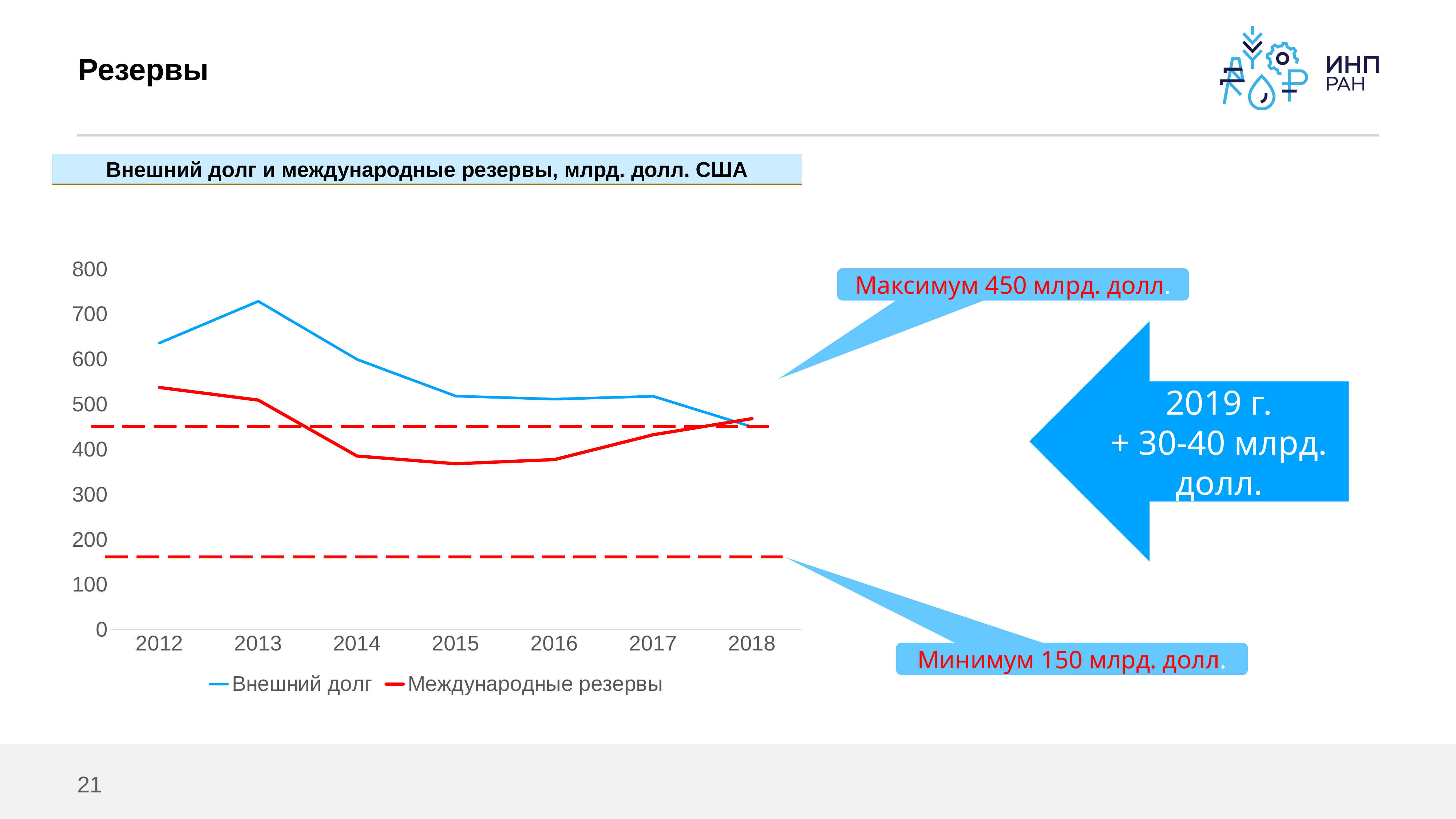
What is the title of the chart? Внешний долг и международные резервы, млрд. долл. США Is the value of Международные резервы in 2015 greater or less than 400? less Is the value of Внешний долг in 2013 greater or less than 700? greater In which year is Внешний долг at its lowest? 2018 In which year are Международные резервы at their highest? 2012 Is the value of Международные резервы in 2012 greater or less than 500? greater In 2012, which is larger: Внешний долг or Международные резервы? Внешний долг What kind of chart is shown on the slide? line chart Does Внешний долг rise or fall from 2013 to 2018? fall In which year is Внешний долг at its highest? 2013 How many series does the chart legend list? 2 How many years are shown on the x axis of the chart? 7